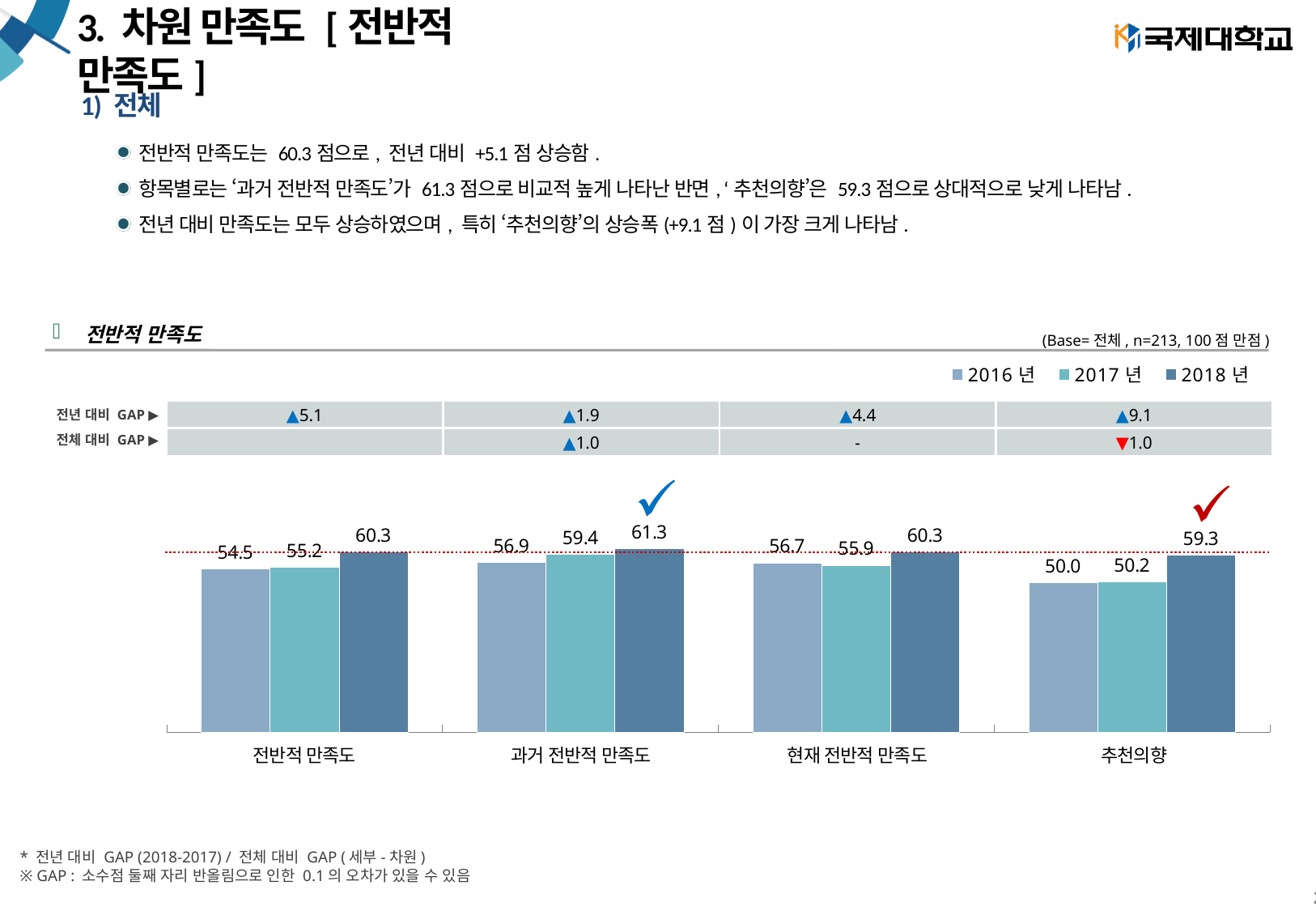
Which category has the lowest 2018년 value? 추천의향 What is the 전년 대비 GAP shown for 현재 전반적 만족도? ▲4.4 What is the difference between the 2018년 and 2017년 values for 추천의향? 9.1 Which category has the highest 2018년 value? 과거 전반적 만족도 What type of chart is shown on the slide? bar chart Which is larger for 전반적 만족도: the 2016년 value or the 2017년 value? 2017년 How many categories are shown on the x axis? 4 What is the 2017년 value for 현재 전반적 만족도? 55.9 What is the 2016년 value for 추천의향? 50.0 How many series does the legend list? 3 What is the 2018년 value for 과거 전반적 만족도? 61.3 Do the values for 과거 전반적 만족도 rise or fall from 2016년 to 2018년? rise